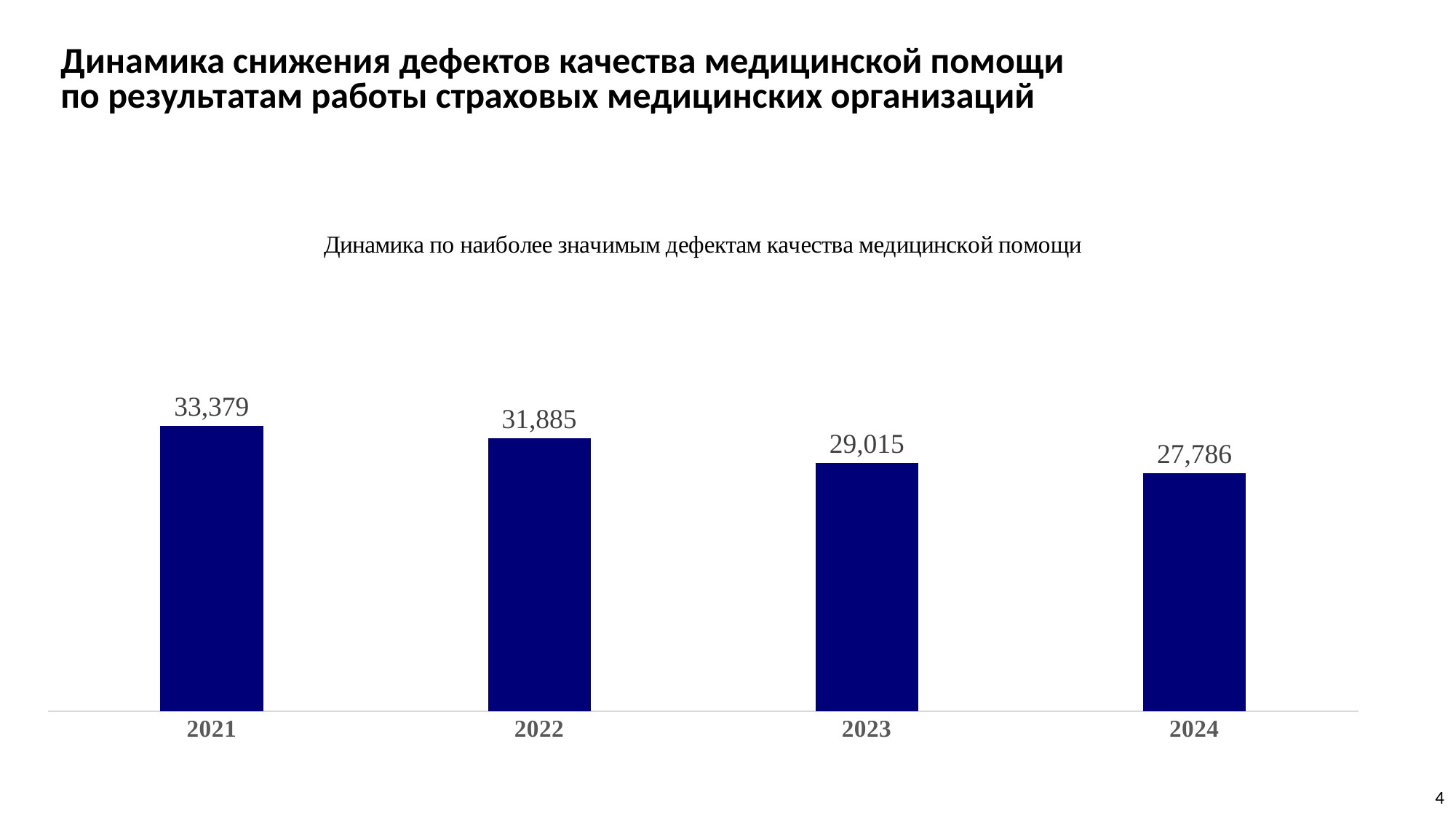
What is the value for 2022? 31,885 How many years are shown on the chart? 4 Which is larger, the value for 2022 or the value for 2023? 2022 Which year has the highest value? 2021 What is the difference between the values for 2021 and 2024? 5,593 What is the value for 2024? 27,786 Which year has the lowest value? 2024 What kind of chart is shown on the slide? Bar chart What is the value for 2021? 33,379 Do the values rise or fall from 2021 to 2024? Fall What is the difference between the values for 2022 and 2023? 2,870 What is the value for 2023? 29,015